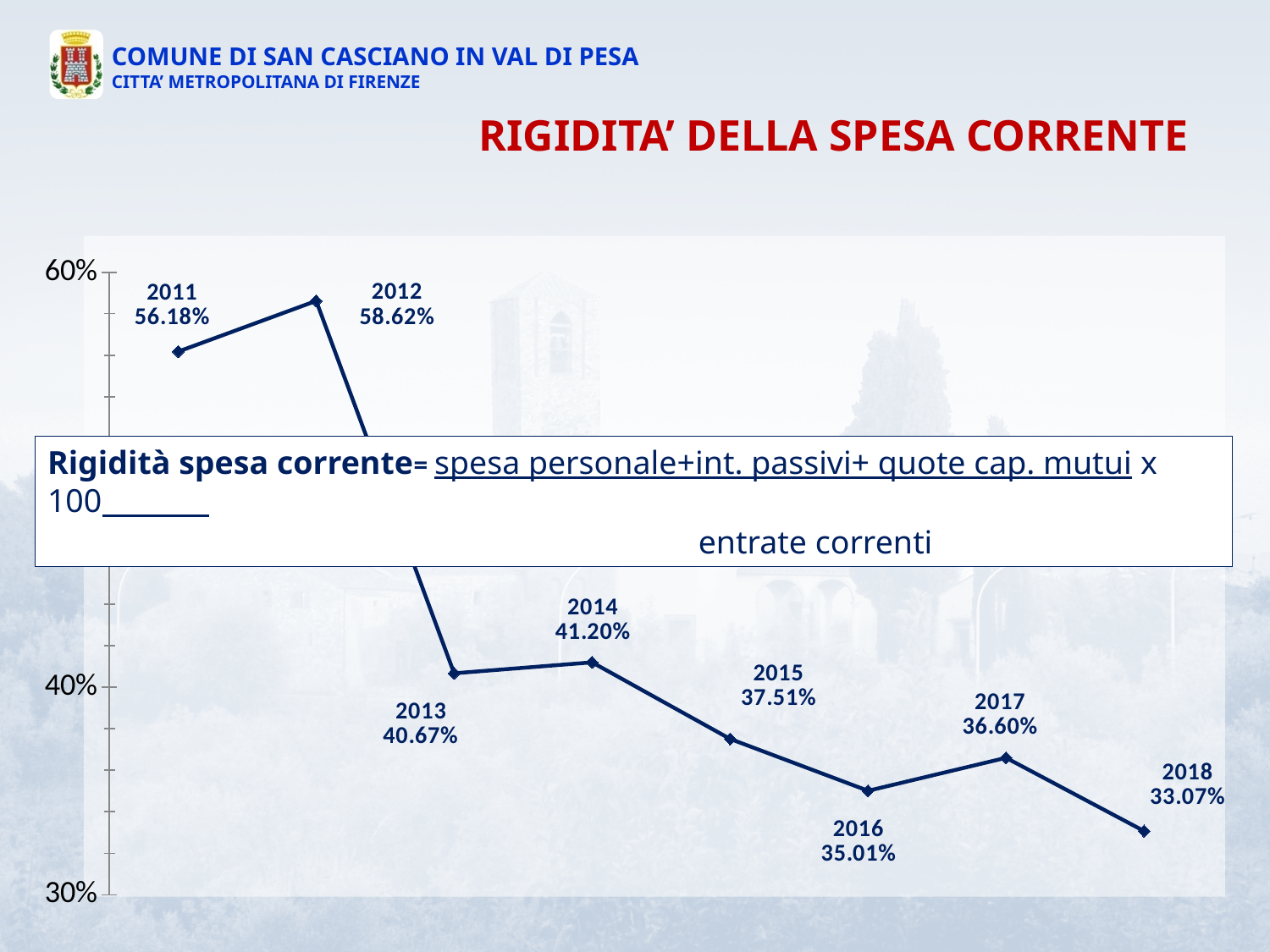
Which is larger, the value for 2014 or the value for 2013? 2014 What is the value for 2018? 33.07% What is the value for 2015? 37.51% What is the title of the slide's chart? RIGIDITA' DELLA SPESA CORRENTE Is the value for 2016 greater or less than 40%? less Which year has the lowest value? 2018 What is the value for 2012? 58.62% Which year has the highest value? 2012 What is the difference between the values for 2017 and 2018? 3.53% What is the difference between the values for 2012 and 2013? 17.95% What kind of chart is shown on the slide? line chart How many years are plotted on the chart? 8